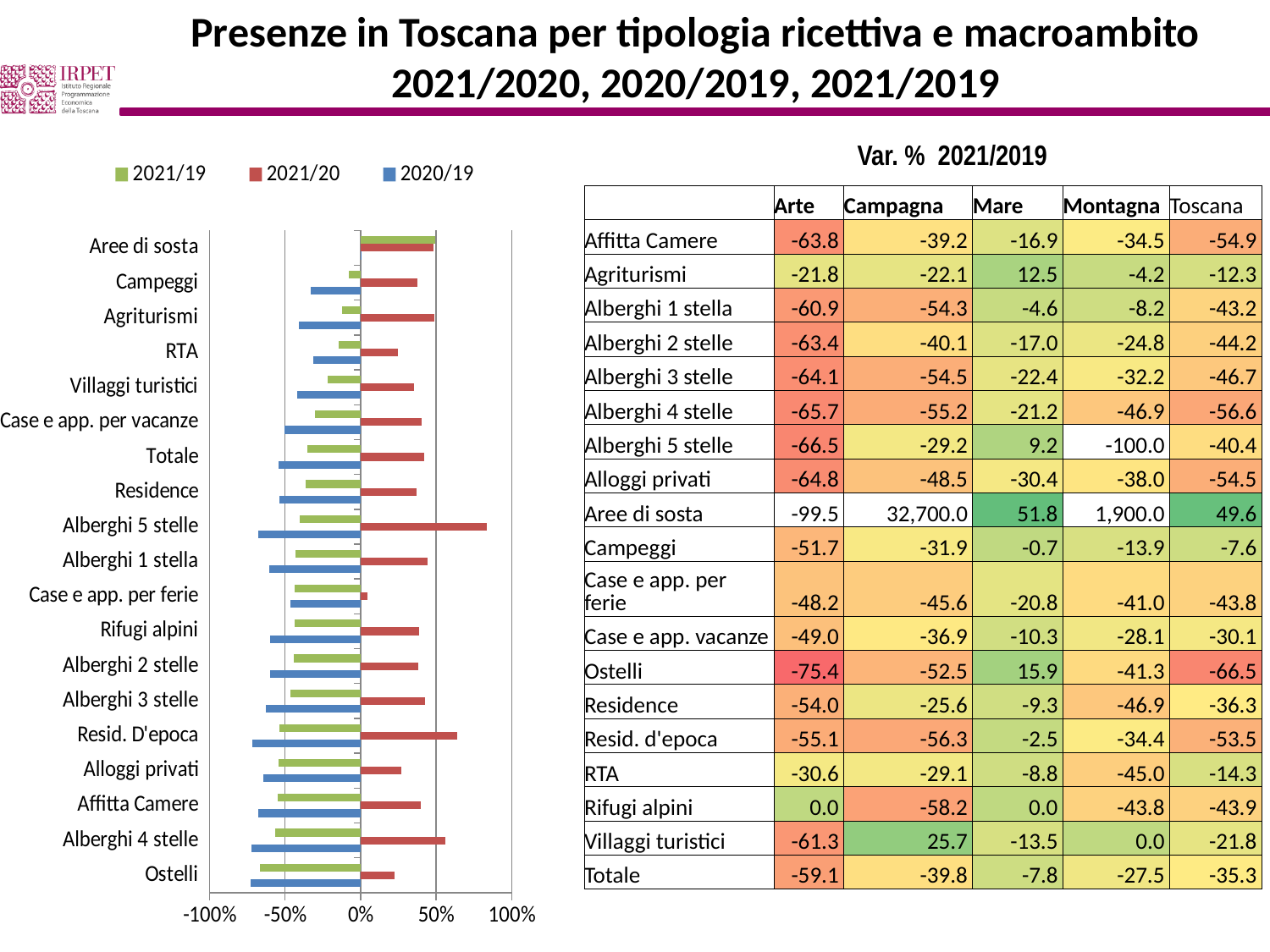
How many series does the legend of the bar chart list? 3 In the bar chart, is the 2021/20 value for Alberghi 5 stelle greater or less than 50%? greater In the bar chart, which category has the highest 2021/20 value? Alberghi 5 stelle Which series in the bar chart is shown in green? 2021/19 Which series in the bar chart is shown in blue? 2020/19 In the bar chart, is the 2021/20 value for Resid. D'epoca greater or less than 50%? greater How many categories are plotted on the bar chart? 19 In the bar chart, which category has the lowest 2021/20 value? Case e app. per ferie In the bar chart, which is larger: the 2020/19 value for Campeggi or the 2020/19 value for Ostelli? Campeggi In the bar chart, is the 2021/19 value for Campeggi greater or less than -50%? greater What kind of chart is shown on the left of the slide? bar chart